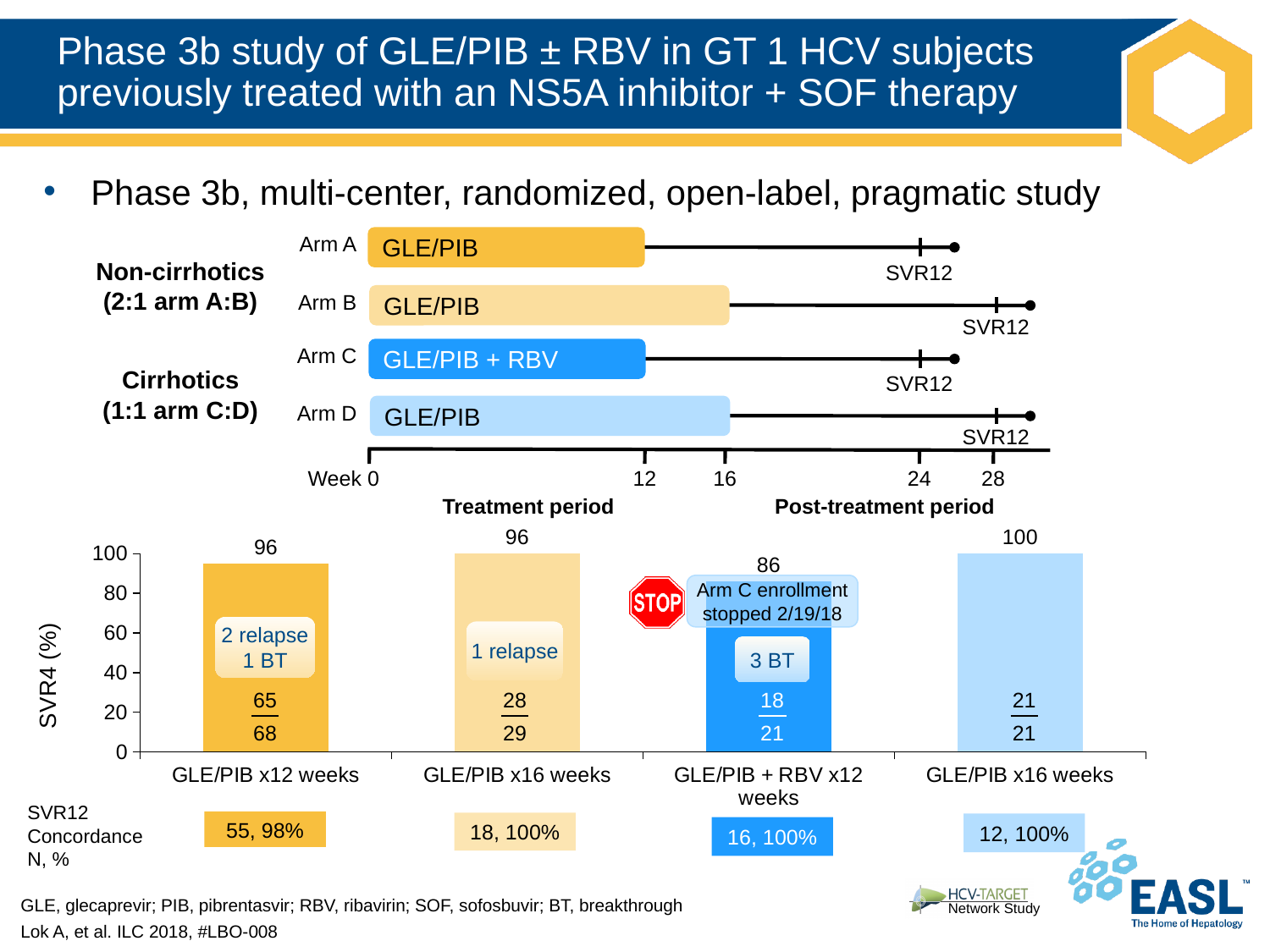
What is the label of the y-axis in the bar chart? SVR4 (%) How many bars are shown in the SVR4 (%) chart? 4 What is the SVR4 (%) value for the GLE/PIB + RBV x12 weeks bar? 86 What is the SVR4 (%) value for the fourth (rightmost) bar, GLE/PIB x16 weeks? 100 What is the difference in SVR4 (%) between the rightmost GLE/PIB x16 weeks bar and the GLE/PIB + RBV x12 weeks bar? 14 Which bar in the SVR4 chart has the lowest value? GLE/PIB + RBV x12 weeks Which bar in the SVR4 chart has the highest value? GLE/PIB x16 weeks (rightmost bar) What type of chart is used to show SVR4 (%)? Bar chart Which has a higher SVR4 (%): GLE/PIB x12 weeks or GLE/PIB + RBV x12 weeks? GLE/PIB x12 weeks What fraction (n/N) is printed on the GLE/PIB x12 weeks bar? 65/68 What fraction (n/N) is printed on the GLE/PIB + RBV x12 weeks bar? 18/21 What is the SVR4 (%) value for the GLE/PIB x12 weeks bar? 96